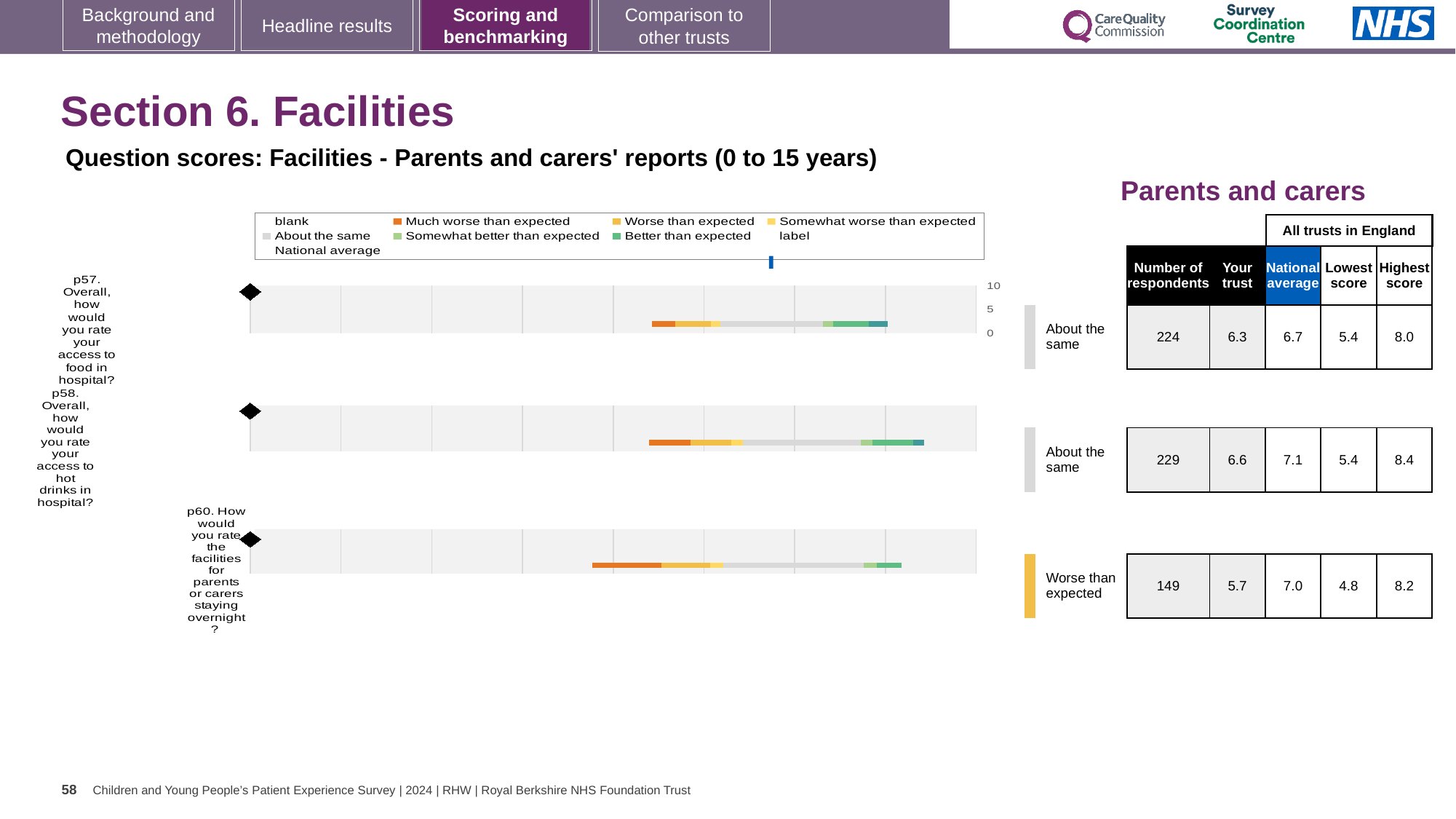
How many respondents answered p60 (facilities for parents or carers staying overnight)? 149 How many questions are plotted on the slide? 3 What is the 'Your trust' score for p57 (access to food in hospital)? 6.3 What is the difference between the national average and the 'Your trust' score for p60? 1.3 What benchmark category is shown for p60? Worse than expected What is the lowest score among all trusts in England for p60? 4.8 What is the highest score among all trusts in England for p58? 8.4 What kind of chart is used to show the question scores? Bar chart Which question has the lowest 'Your trust' score? p60 (facilities for parents or carers staying overnight) What is the national average score for p58 (access to hot drinks in hospital)? 7.1 Which question has the highest number of respondents? p58 (access to hot drinks in hospital) Which has the higher 'Your trust' score, p57 or p58? p58